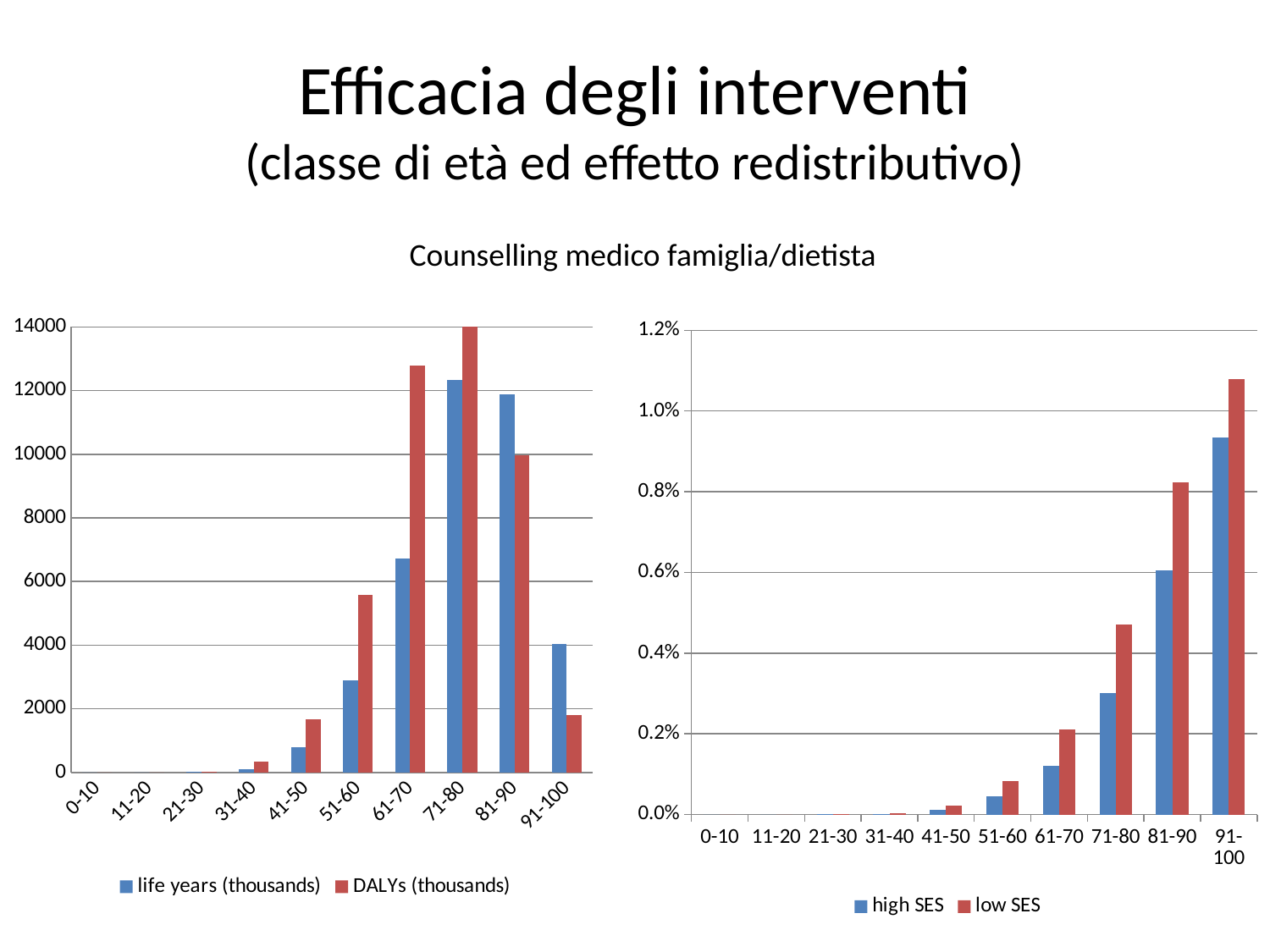
In the right chart, which age class has the highest low SES value? 91-100 In the left chart, which age class has the highest DALYs (thousands) value? 71-80 In the left chart, for the 81-90 age class, which is larger: life years (thousands) or DALYs (thousands)? life years (thousands) In the left chart, is the DALYs (thousands) value for 71-80 greater or less than 12000? greater How many age classes are shown on the x axis of the right chart? 10 In the left chart, is the DALYs (thousands) value for 51-60 greater or less than 6000? less What kind of chart is the left chart on the slide? bar chart In the left chart, which age class has the highest life years (thousands) value? 71-80 In the right chart, do the low SES values generally rise or fall as age class increases along the x axis? rise How many series does the legend of the left chart list? 2 In the right chart, is the low SES value for 91-100 greater or less than 1.0%? greater